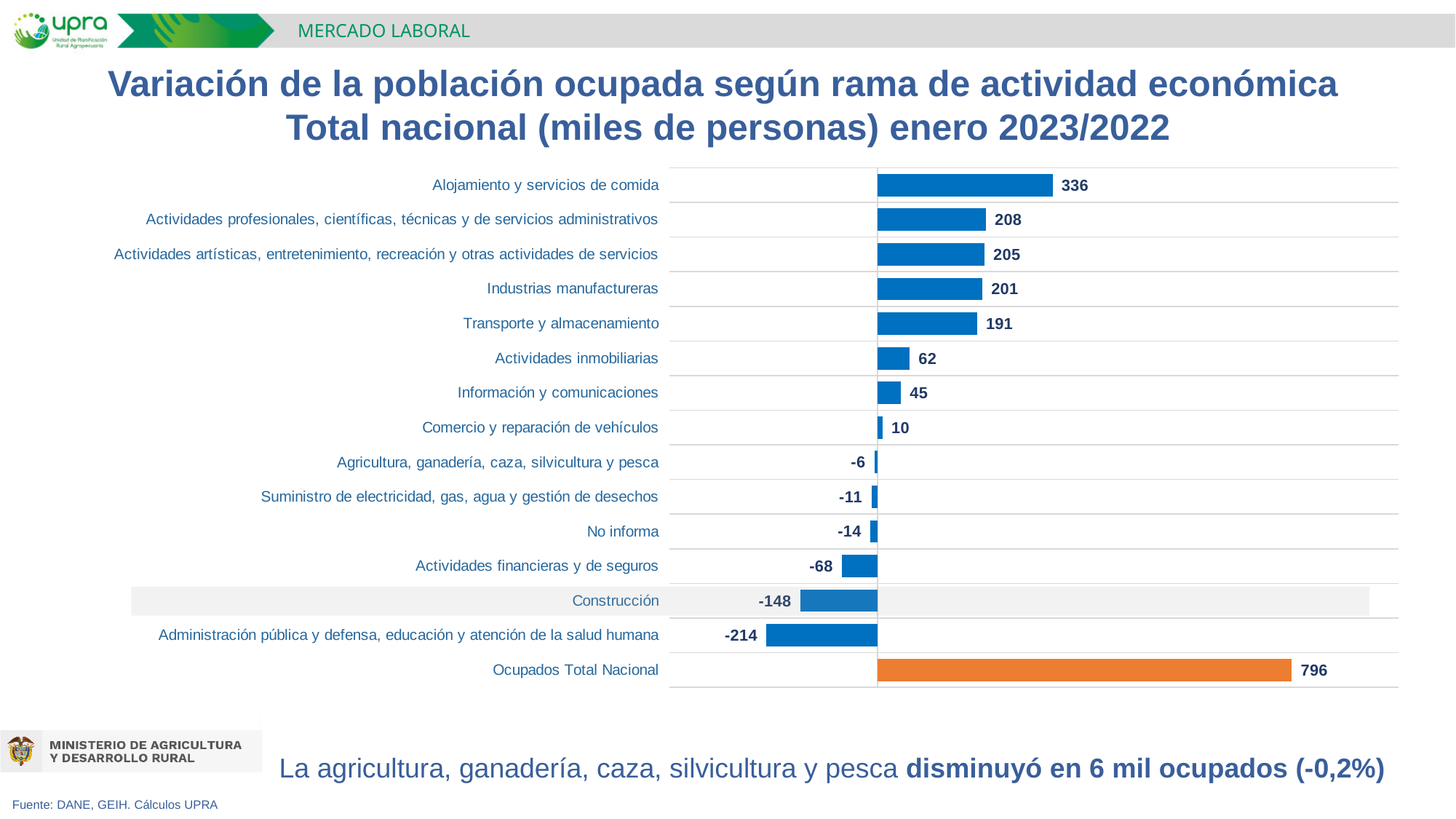
What is the value for Construcción? -148 What is the value for Agricultura, ganadería, caza, silvicultura y pesca? -6 Which category has the lowest value? Administración pública y defensa, educación y atención de la salud humana How many categories are shown in the chart? 15 What is the value for Ocupados Total Nacional? 796 Which is larger, the value for Industrias manufactureras or the value for Transporte y almacenamiento? Industrias manufactureras What is the difference between the values for Alojamiento y servicios de comida and Actividades profesionales, científicas, técnicas y de servicios administrativos? 128 Which category has the highest value? Ocupados Total Nacional What colour is the bar for Ocupados Total Nacional? Orange What is the difference between the values for Actividades inmobiliarias and Información y comunicaciones? 17 What is the value for Alojamiento y servicios de comida? 336 What kind of chart is shown on the slide? Bar chart